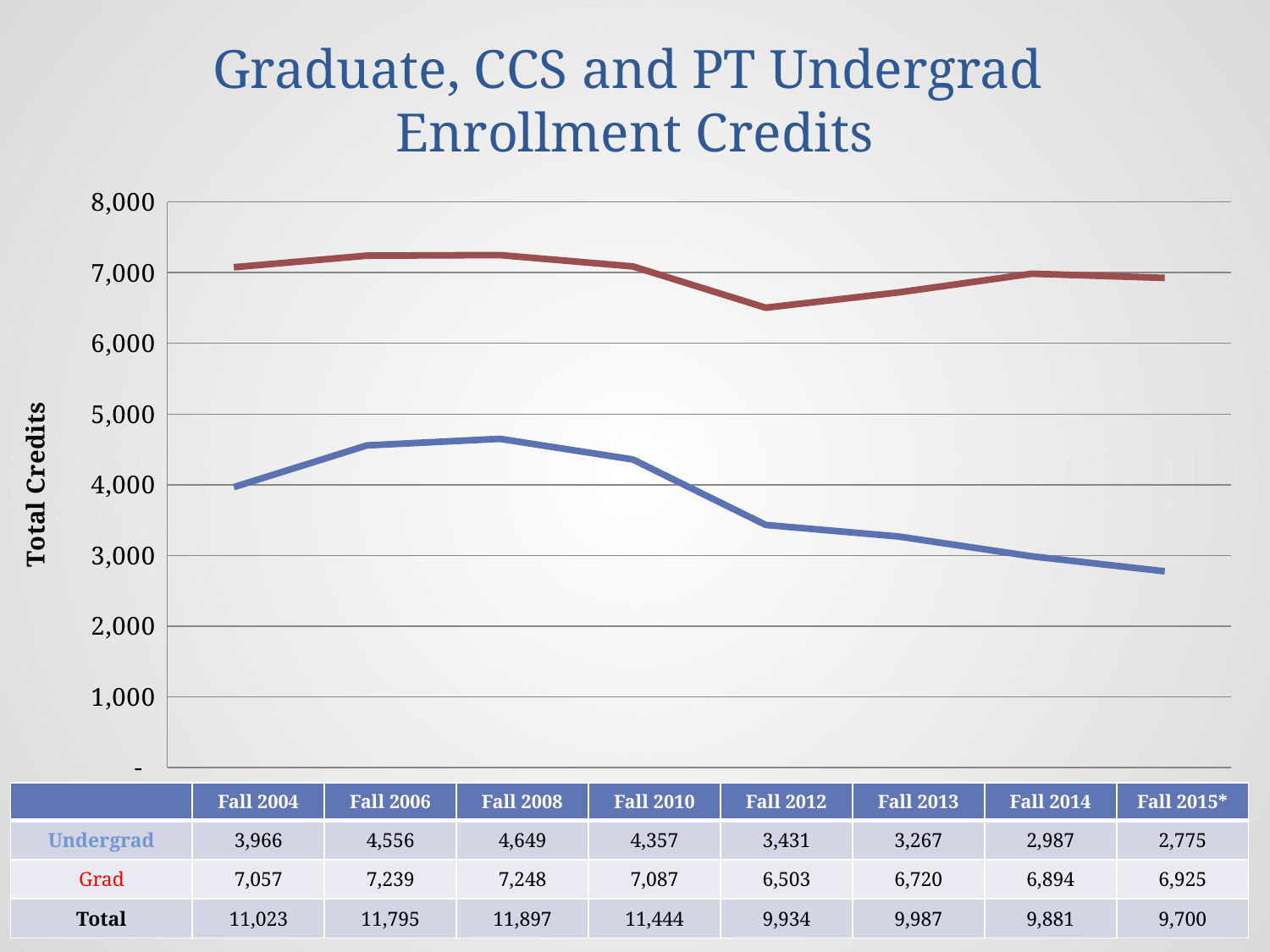
How many terms are plotted on the x axis? 8 Does the Undergrad line rise or fall from Fall 2008 to Fall 2015*? fall Is the Grad value for Fall 2013 greater or less than 7,000? less What kind of chart is shown on the slide? line chart In which term is the Undergrad value highest? Fall 2008 What is the difference between the Grad and Undergrad values in Fall 2004? 3,091 How many data series are plotted as lines in the chart? 2 What is the Total for Fall 2015*? 9,700 Which is larger, the Undergrad value for Fall 2006 or for Fall 2014? Fall 2006 What is the Grad value for Fall 2012? 6,503 In which term is the Grad value lowest? Fall 2012 What is the Undergrad value for Fall 2008? 4,649